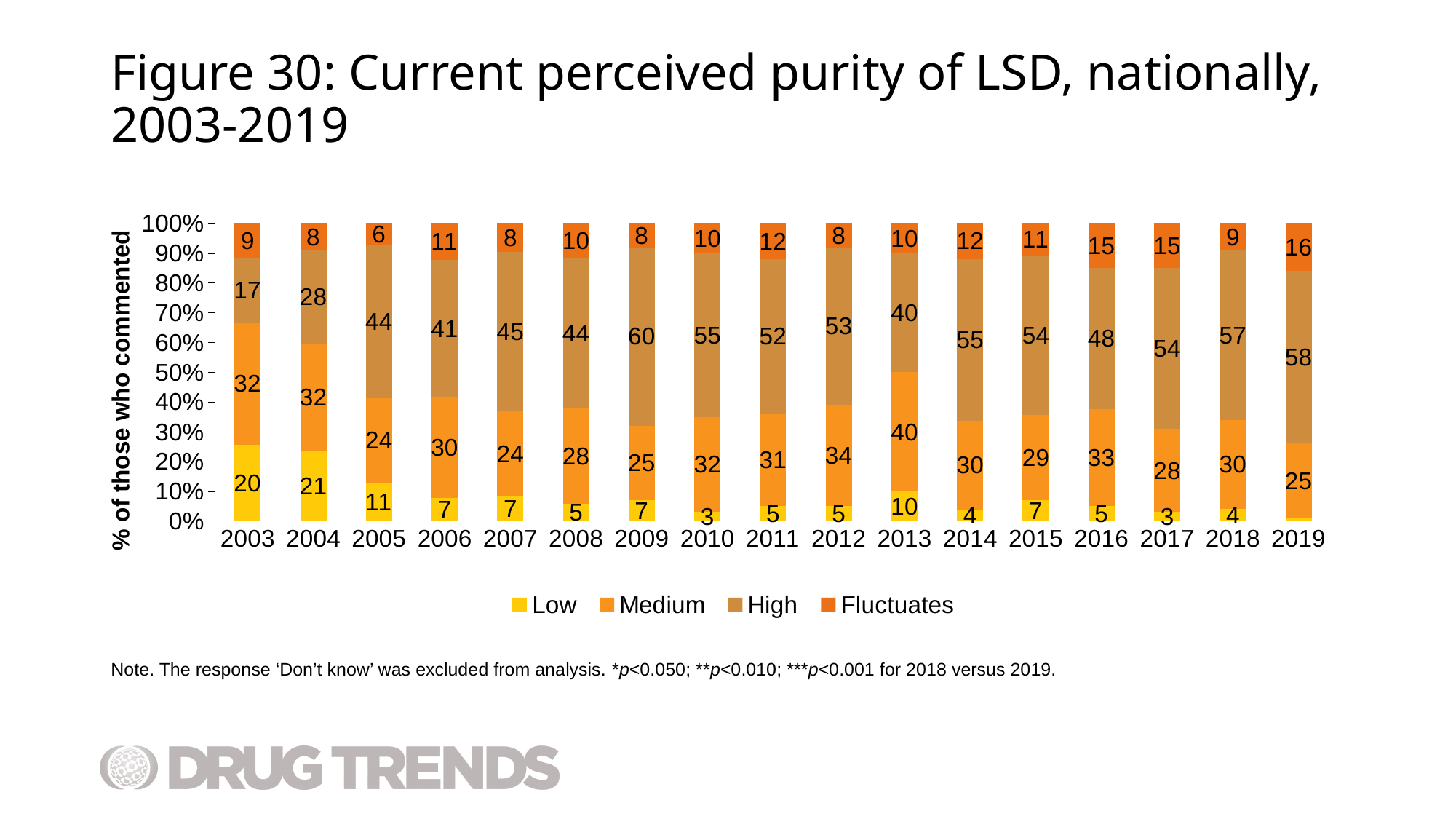
What kind of chart is this? Stacked bar chart In which year is the Low segment highest? 2004 In which year is the High segment lowest? 2003 What is the value for Fluctuates in 2019? 16 Which is larger, the Medium value in 2012 or the Medium value in 2017? 2012 What is the value for Medium in 2013? 40 What is the difference between the High values for 2019 and 2018? 1 What is the value for High in 2009? 60 Which series is shown in yellow in the legend? Low How many series does the legend list? 4 How many years are shown on the x axis? 17 What is the value for Low in 2003? 20